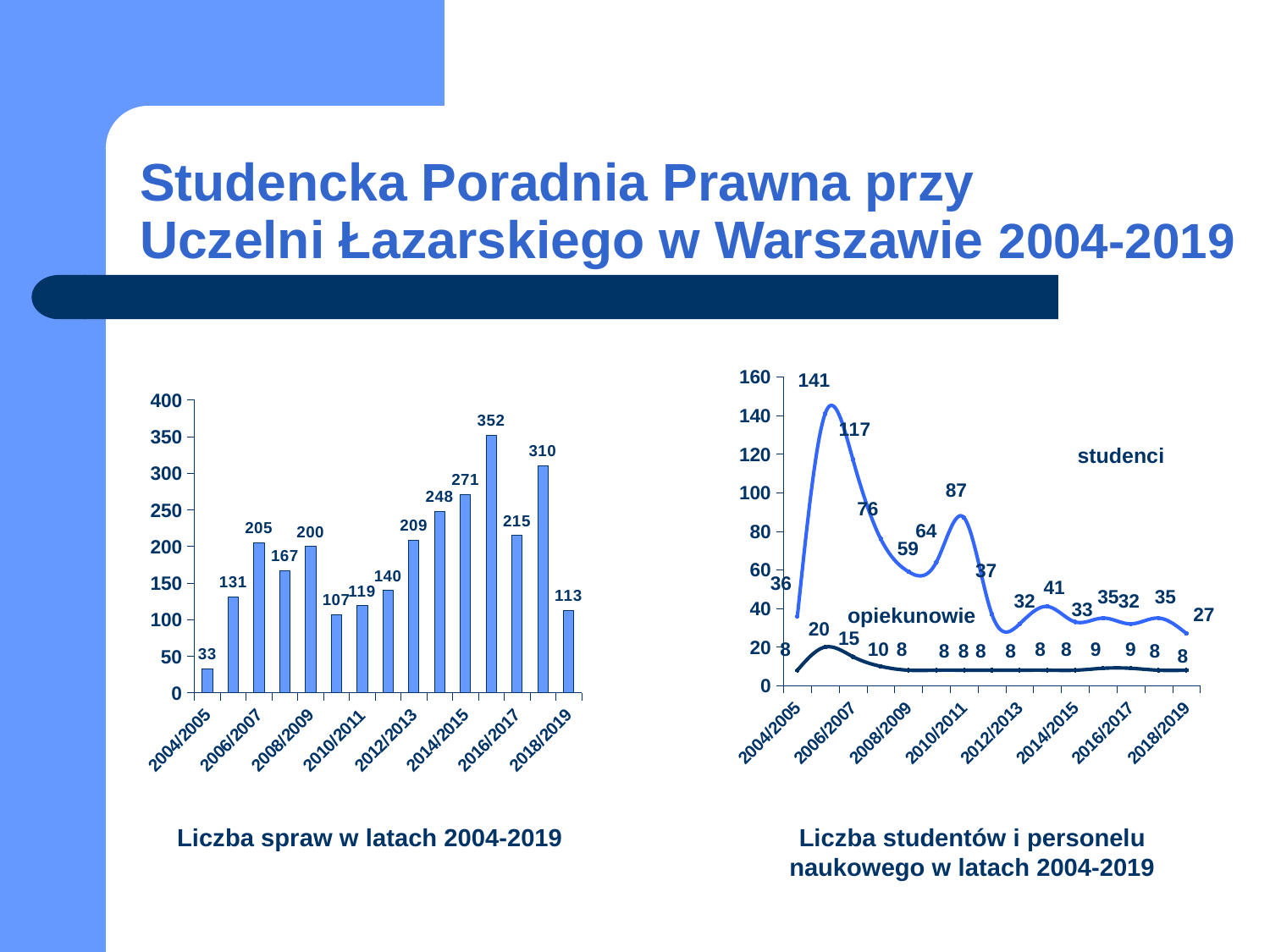
What kind of chart is the right chart, 'Liczba studentów i personelu naukowego w latach 2004-2019'? line chart In the left chart 'Liczba spraw w latach 2004-2019', what is the value for 2018/2019? 113 In the left chart 'Liczba spraw w latach 2004-2019', what is the highest value shown? 352 How many bars are plotted in the left chart 'Liczba spraw w latach 2004-2019'? 15 In the right chart 'Liczba studentów i personelu naukowego w latach 2004-2019', what is the value for studenci in 2004/2005? 36 In the left chart 'Liczba spraw w latach 2004-2019', which year has the lowest value? 2004/2005 In the left chart 'Liczba spraw w latach 2004-2019', what is the difference between the values for 2018/2019 and 2004/2005? 80 How many series are plotted in the right chart 'Liczba studentów i personelu naukowego w latach 2004-2019'? 2 In the left chart 'Liczba spraw w latach 2004-2019', what is the value for 2004/2005? 33 In the right chart 'Liczba studentów i personelu naukowego w latach 2004-2019', which series has the larger value in 2018/2019, studenci or opiekunowie? studenci What kind of chart is the left chart, 'Liczba spraw w latach 2004-2019'? bar chart In the right chart 'Liczba studentów i personelu naukowego w latach 2004-2019', what is the highest value for studenci? 141